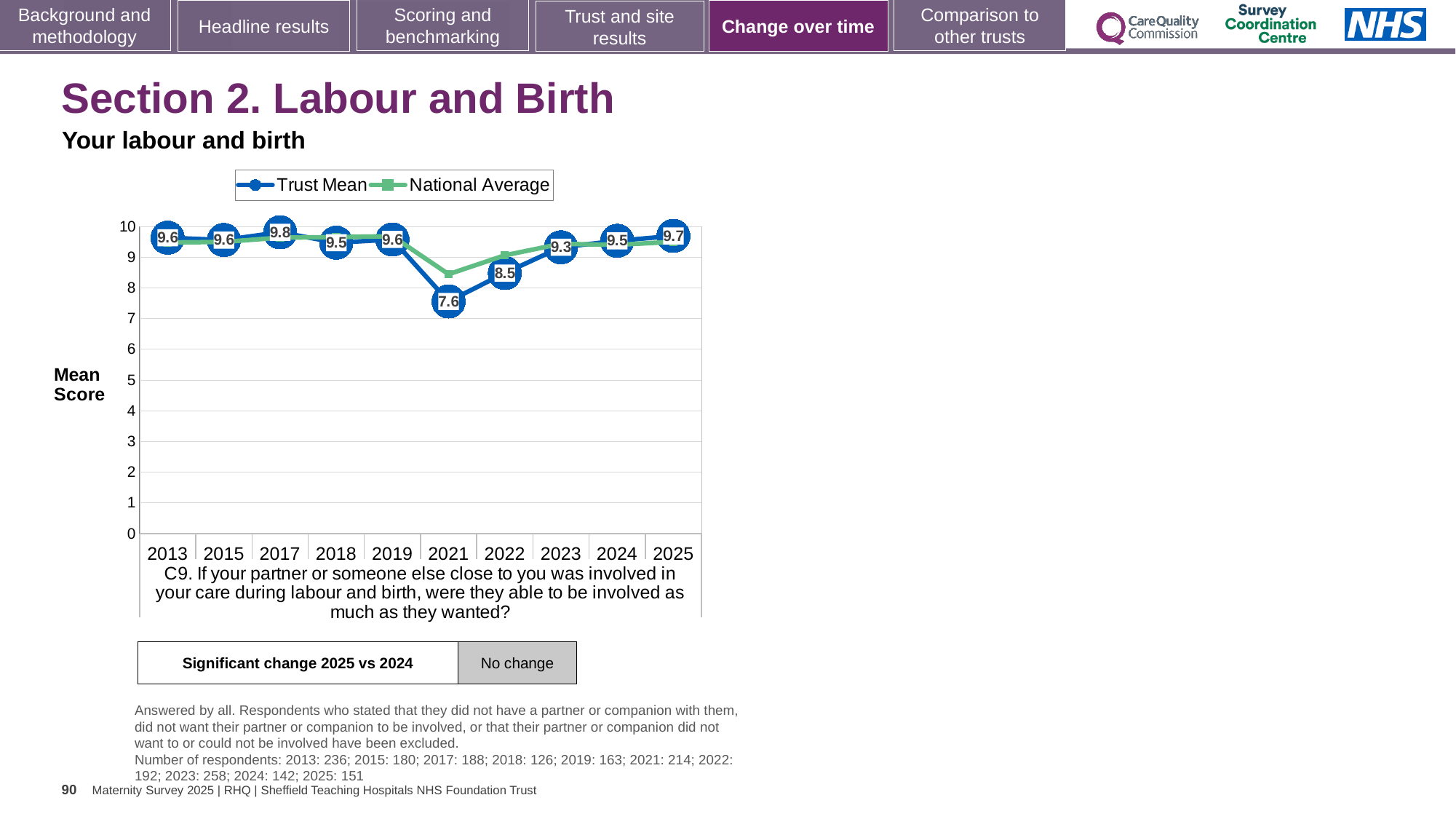
In which year is the Trust Mean highest? 2017 In which year is the Trust Mean lowest? 2021 What is the Trust Mean value for 2017? 9.8 Does the Trust Mean rise or fall from 2021 to 2025? Rise What is the Trust Mean value for 2021? 7.6 How many series does the legend list? 2 Which is larger, the Trust Mean in 2022 or in 2023? 2023 Is the National Average value for 2021 greater or less than 8? greater What is the Trust Mean value for 2025? 9.7 What kind of chart is shown on the slide? Line chart How many years are shown on the x axis? 10 What is the difference between the Trust Mean in 2025 and in 2024? 0.2